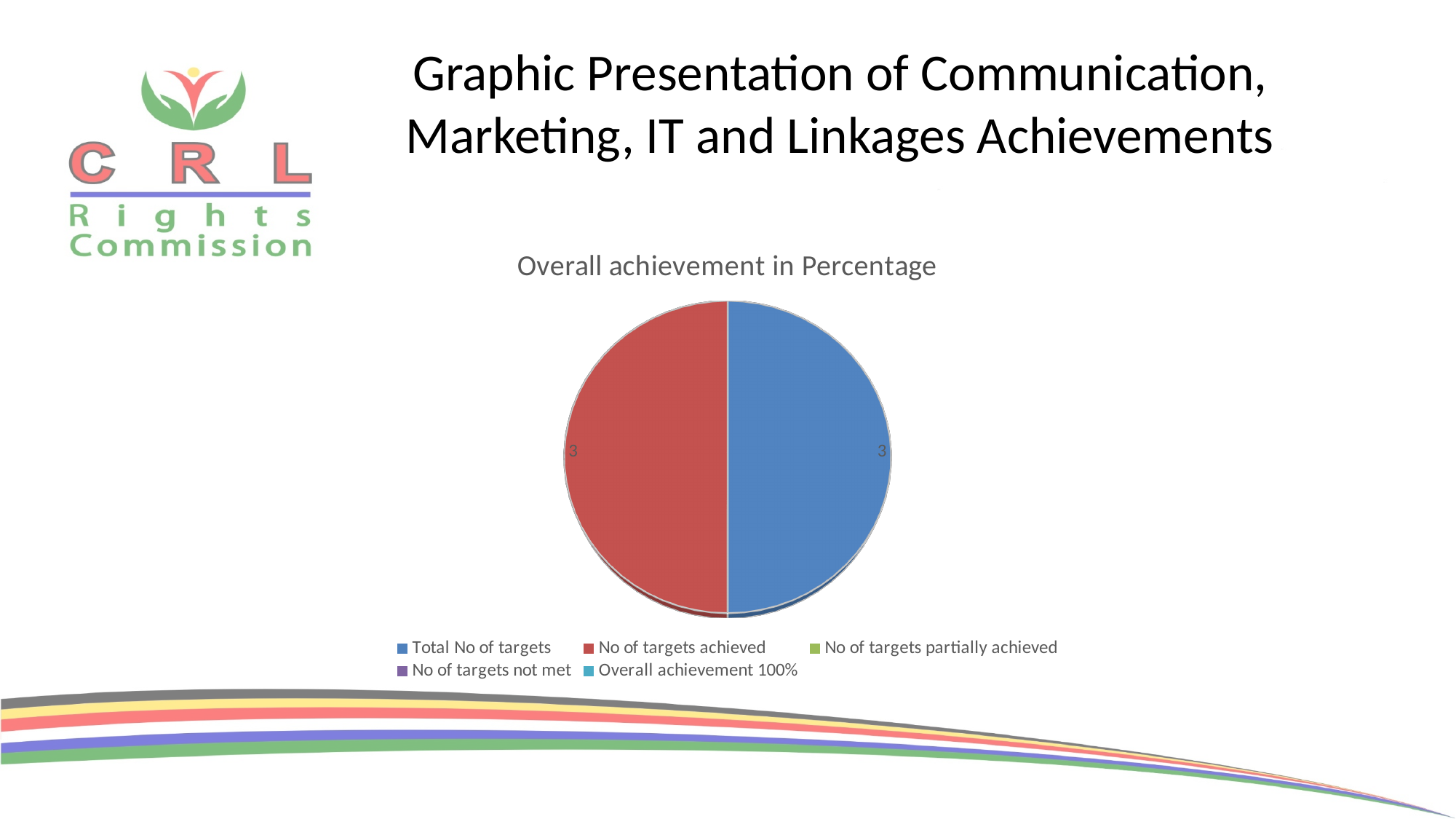
How many slices are visible in the pie chart? 2 What is the total of the values shown on the pie chart? 6 What is the value shown for Total No of targets? 3 What is the value shown for No of targets achieved? 3 What share of the pie does the Total No of targets slice represent? 50% What share of the pie does the No of targets achieved slice represent? 50% How many entries does the legend list? 5 What is the difference between the values for Total No of targets and No of targets achieved? 0 What kind of chart is shown on the slide? pie chart What is the title of the chart? Overall achievement in Percentage What colour is the slice for No of targets achieved? red